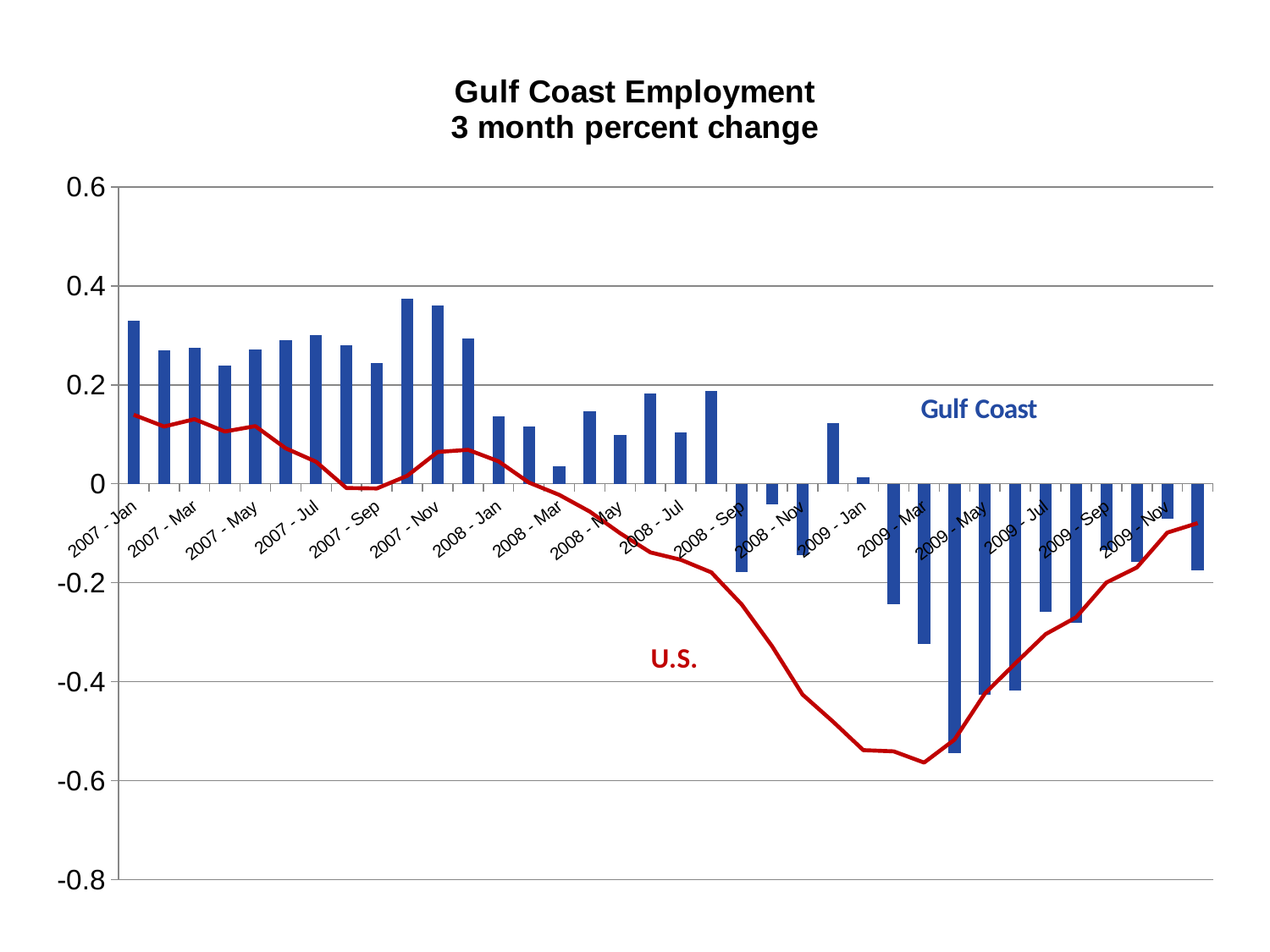
What colour is the U.S. line? Red At 2009 - Jan, which series has the higher value, Gulf Coast or U.S.? Gulf Coast Is the Gulf Coast value for 2009 - Mar greater or less than -0.2? less What is the title of the chart? Gulf Coast Employment 3 month percent change Which is larger, the Gulf Coast value for 2007 - Jan or for 2008 - Jan? 2007 - Jan Is the Gulf Coast value for 2009 - May greater or less than -0.4? less What kind of chart is used to show the Gulf Coast series? Bar chart How many series are shown on the chart? 2 Is the U.S. value for 2007 - Jan greater or less than 0.2? less Does the U.S. line rise or fall from 2009 - Mar to 2009 - Nov? Rise